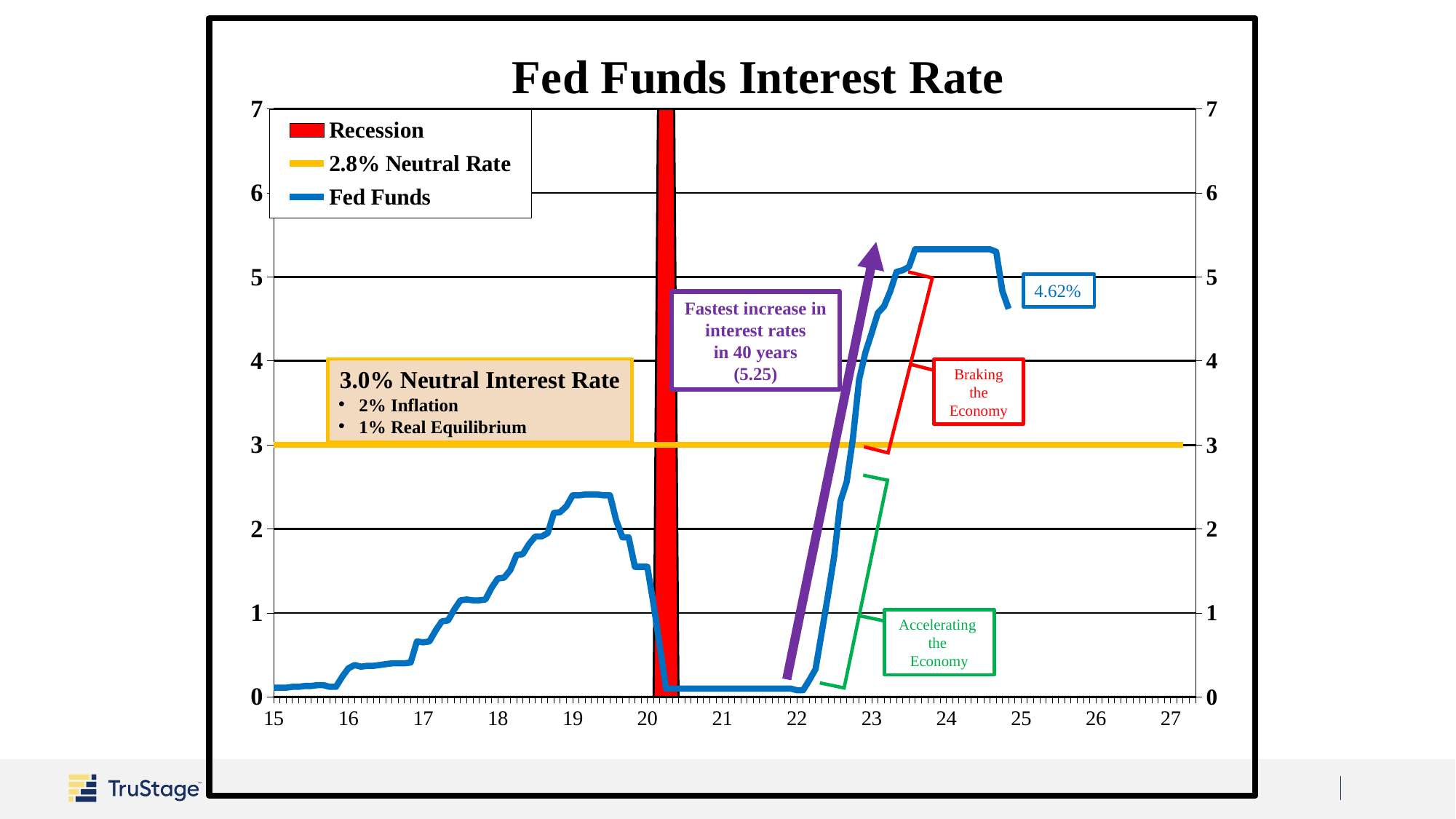
What colour is the Fed Funds line in the legend? blue At which y-axis value is the yellow neutral rate line drawn? 3 Is the Fed Funds value at year 21 greater or less than 1? less Does the Fed Funds line rise or fall between year 15 and year 19? rise Is the Fed Funds value at year 19 greater or less than 2? greater What is the value shown by the data label at the end of the Fed Funds line? 4.62% What kind of chart is shown on the slide? line chart Does the Fed Funds line rise or fall between year 22 and year 23? rise What is the title of the chart? Fed Funds Interest Rate Which is larger, the Fed Funds value at year 17 or at year 19? year 19 How many entries does the chart's legend list? 3 Is the Fed Funds value at year 24 greater or less than 5? greater